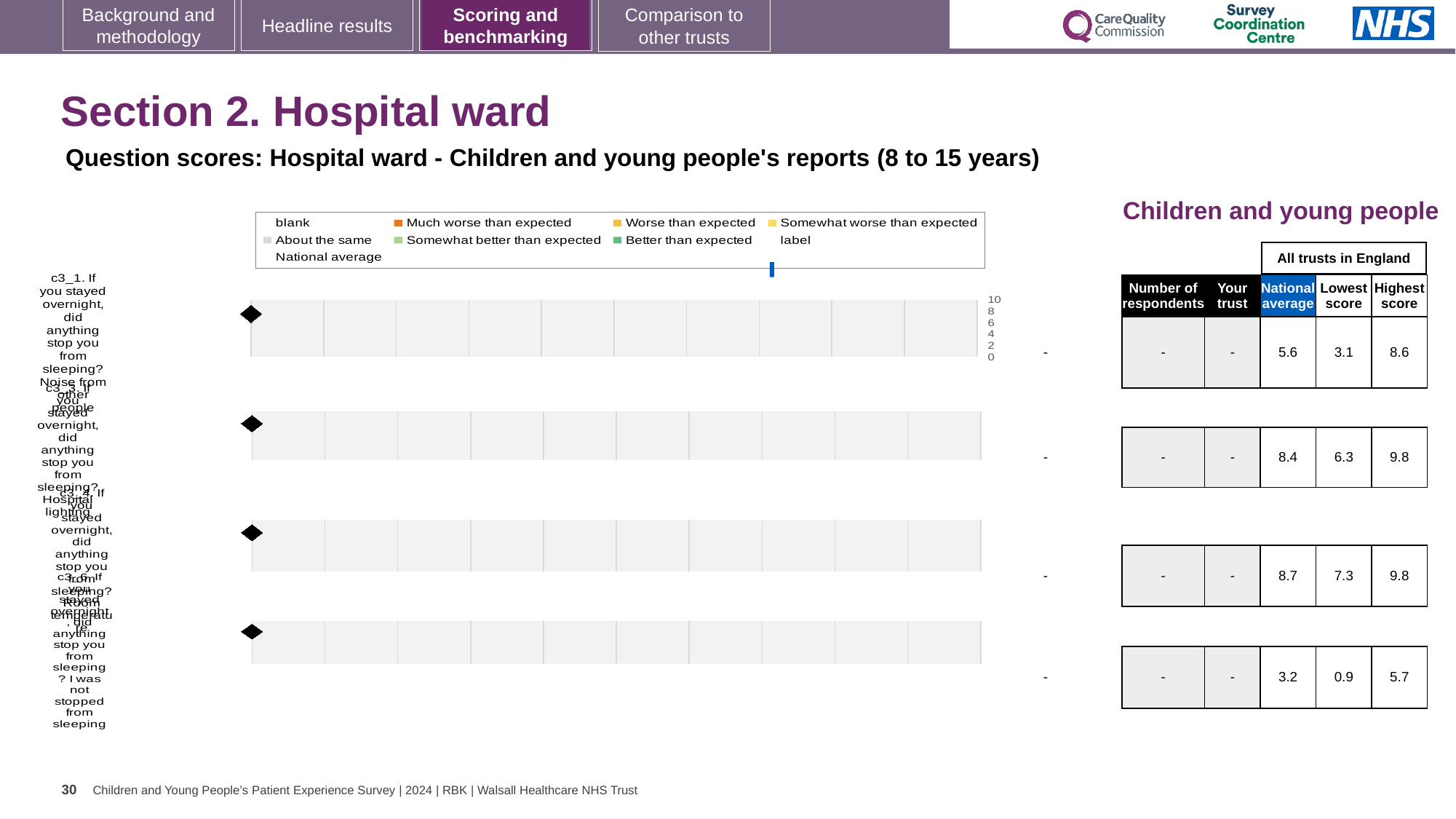
In the table next to the chart, is the National average for c3_3 (hospital lighting) larger or smaller than that for c3_1 (noise from other people)? larger What kind of chart is shown on the slide? bar chart In the table next to the chart, what is the Lowest score for the fourth row (c3_6, I was not stopped from sleeping)? 0.9 How many entries does the chart legend list? 9 What is the maximum value shown on the chart's axis? 10 In the table next to the chart, which row has the highest National average? c3_4 (Room temperature) In the table next to the chart, what is the difference between the Highest score and Lowest score for the first row (c3_1)? 5.5 Which legend entry is shown with an orange marker? Much worse than expected In the table next to the chart, what is the National average for the first row (c3_1, noise from other people)? 5.6 In the table next to the chart, which row has the lowest National average? c3_6 (I was not stopped from sleeping) How many question categories (rows) are plotted in the chart? 4 In the table next to the chart, what is the Highest score for the second row (c3_3, hospital lighting)? 9.8